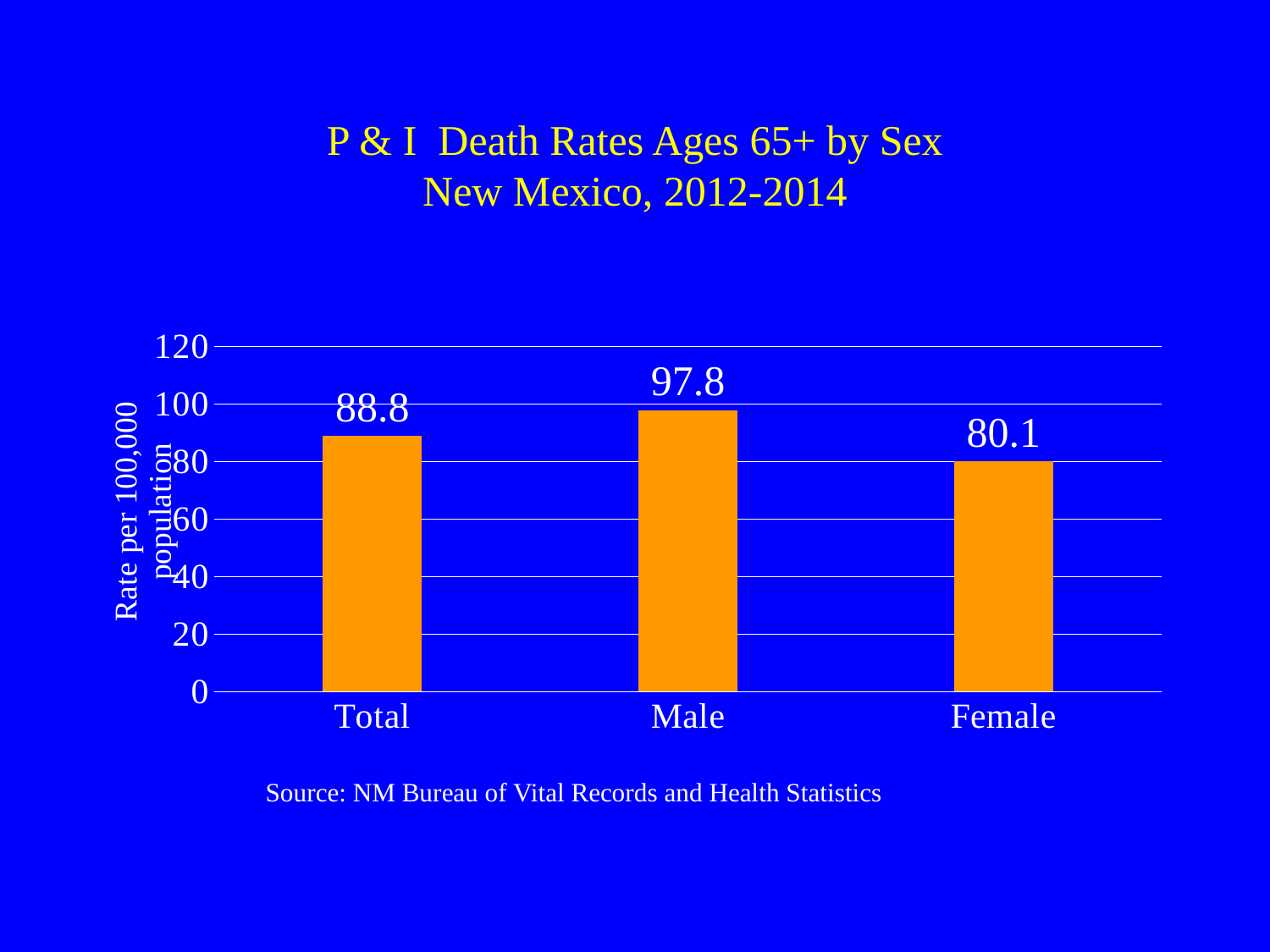
What is the label of the y axis? Rate per 100,000 population Which category has the lowest death rate? Female Is the value for Female greater or less than 100? less What is the P & I death rate for Female? 80.1 What is the P & I death rate for Total? 88.8 Which category has the highest death rate? Male What is the difference between the Male and Female death rates? 17.7 Which is larger, the death rate for Male or for Female? Male What is the P & I death rate for Male? 97.8 What kind of chart is shown on the slide? bar chart What is the difference between the Male and Total death rates? 9.0 How many categories are shown on the x axis? 3